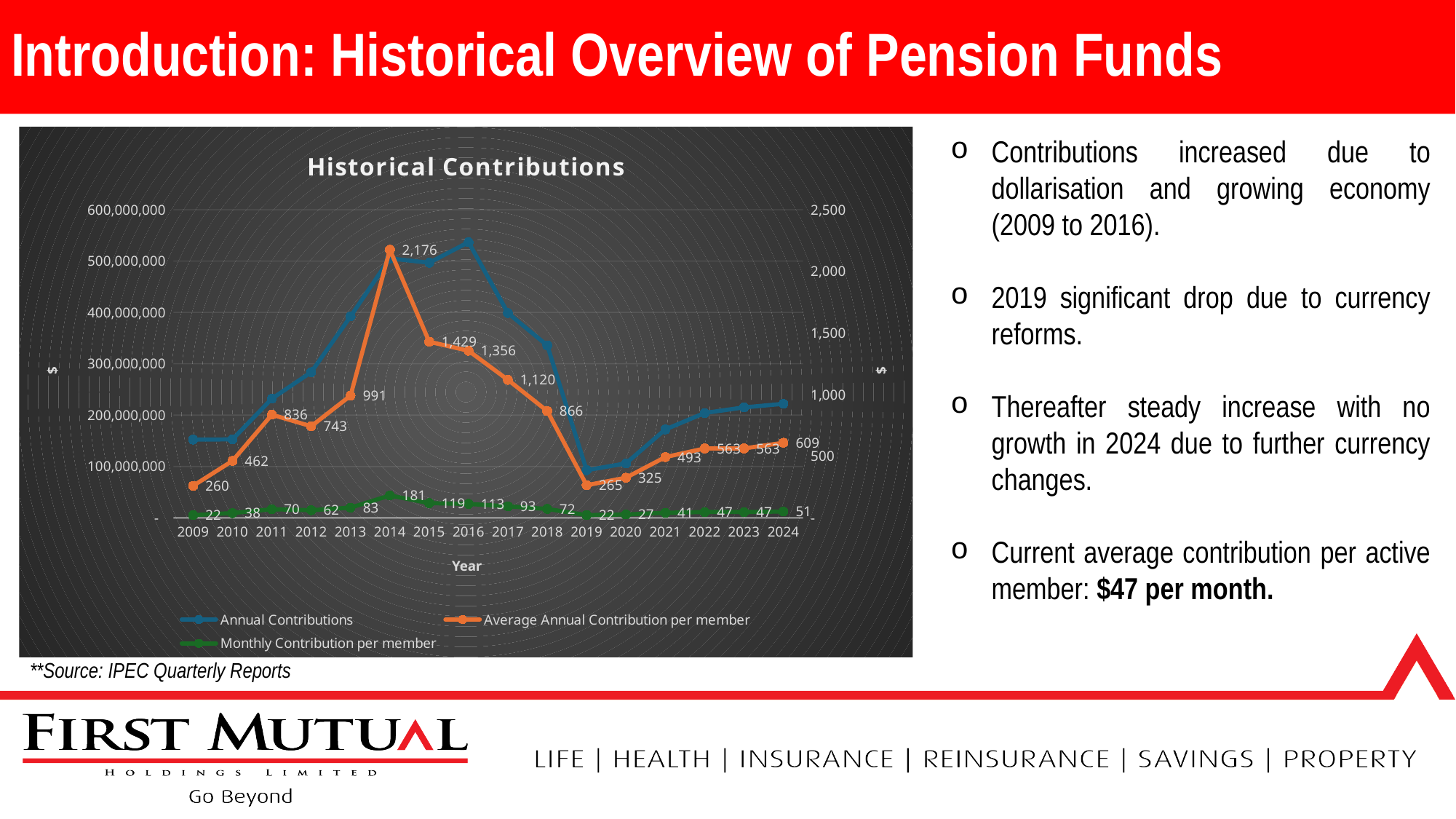
In which year is the Average Annual Contribution per member highest? 2014 How many years are plotted along the x axis of the Historical Contributions chart? 16 How many series does the legend of the Historical Contributions chart list? 3 Does the Average Annual Contribution per member rise or fall from 2014 to 2019? Fall In which year is the Monthly Contribution per member highest? 2014 Is the value of Annual Contributions in 2016 greater or less than 500,000,000? greater What is the Average Annual Contribution per member in 2014? 2,176 Which year has the larger Average Annual Contribution per member, 2011 or 2012? 2011 What type of chart is shown on the slide? Line chart What is the title of the x axis of the chart? Year What is the difference between the Average Annual Contribution per member in 2014 and in 2015? 747 What is the Monthly Contribution per member in 2024? 51